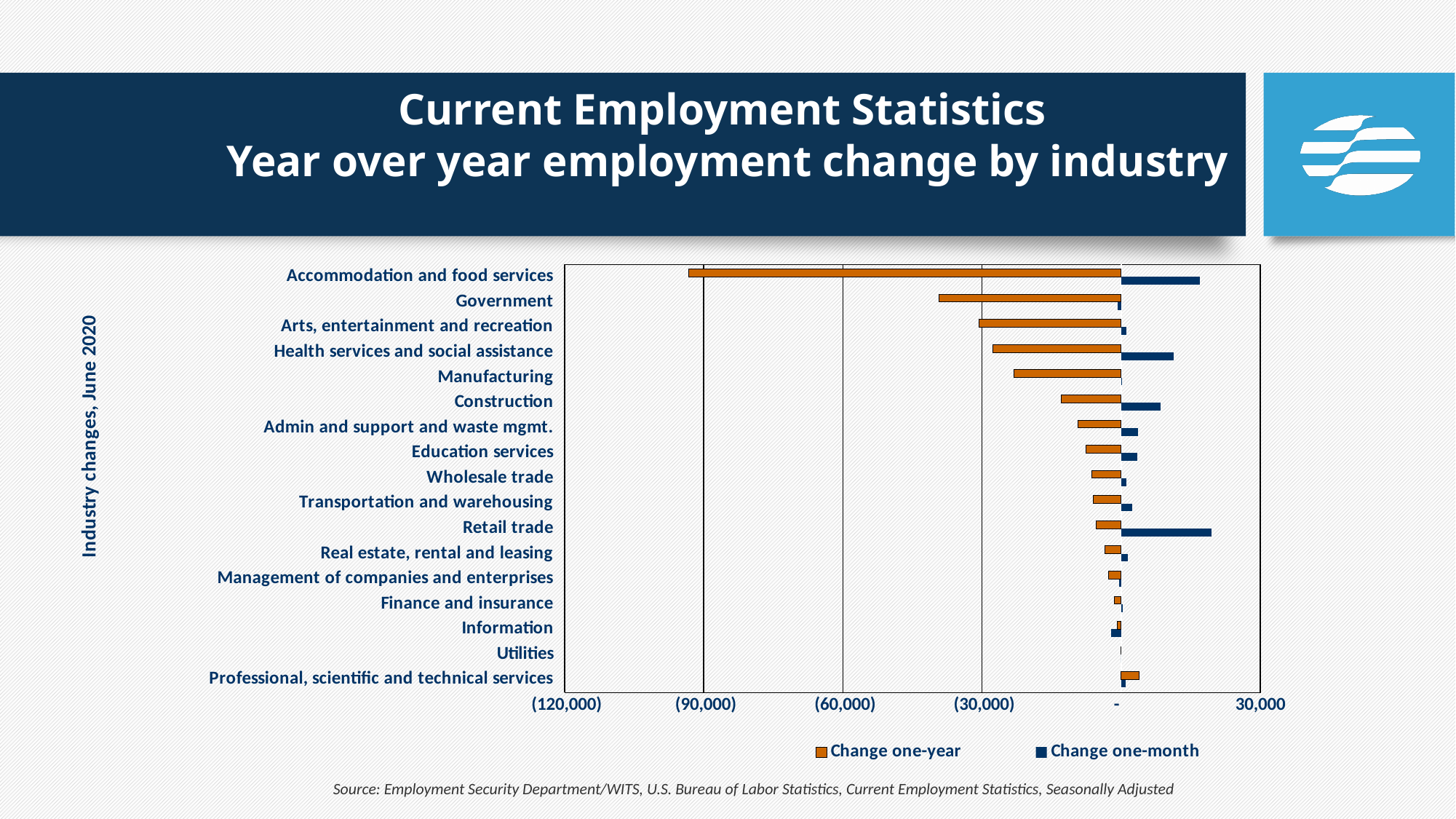
Which has the larger one-year decline, Government or Manufacturing? Government Which industry has the largest positive one-month change? Retail trade What kind of chart is shown on the slide? Bar chart Which has the larger one-month increase, Retail trade or Construction? Retail trade Is the one-year change for Government greater or less than (30,000)? less Is the one-year change for Manufacturing greater or less than (30,000)? greater Is the one-year change for Accommodation and food services greater or less than (60,000)? less Which industry is the only one with a positive one-year change? Professional, scientific and technical services How many industries are listed on the chart? 17 Which industry has the largest one-year employment decline? Accommodation and food services What are the two legend entries on the chart? Change one-year; Change one-month How many series does the legend list? 2